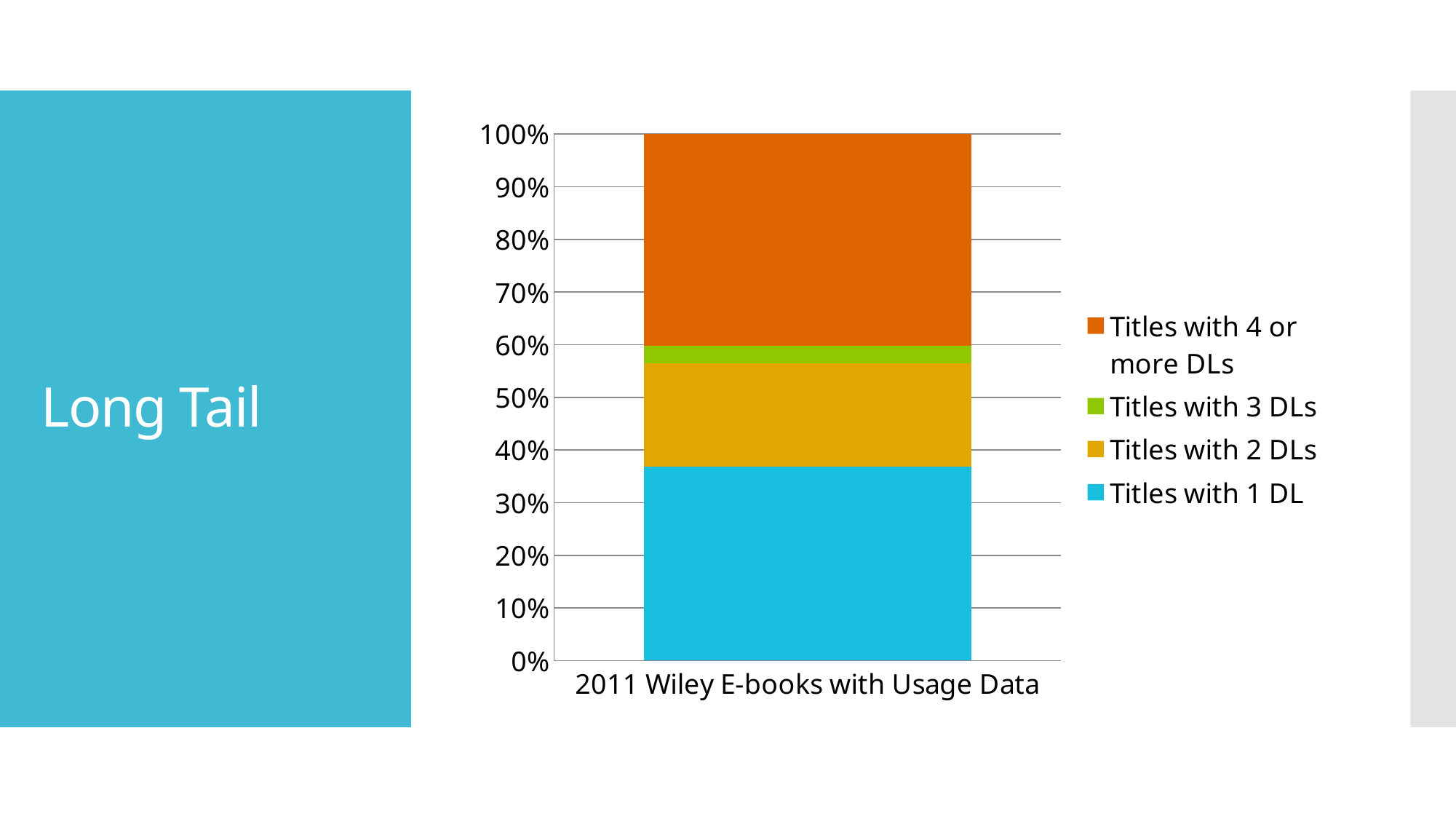
How many series does the legend list? 4 Which segment is larger, Titles with 1 DL or Titles with 2 DLs? Titles with 1 DL Which colour represents Titles with 4 or more DLs in the legend? orange Which segment is larger, Titles with 2 DLs or Titles with 3 DLs? Titles with 2 DLs What is the total height of the stacked bar for 2011 Wiley E-books with Usage Data? 100% Which series has the smallest segment in the stacked bar? Titles with 3 DLs Is the segment for Titles with 1 DL greater or less than 40%? less Is the segment for Titles with 3 DLs greater or less than 10%? less What is the label of the single category on the x axis? 2011 Wiley E-books with Usage Data Is the segment for Titles with 1 DL greater or less than 30%? greater What kind of chart is shown on the slide? stacked bar chart How many categories are plotted on the x axis? 1